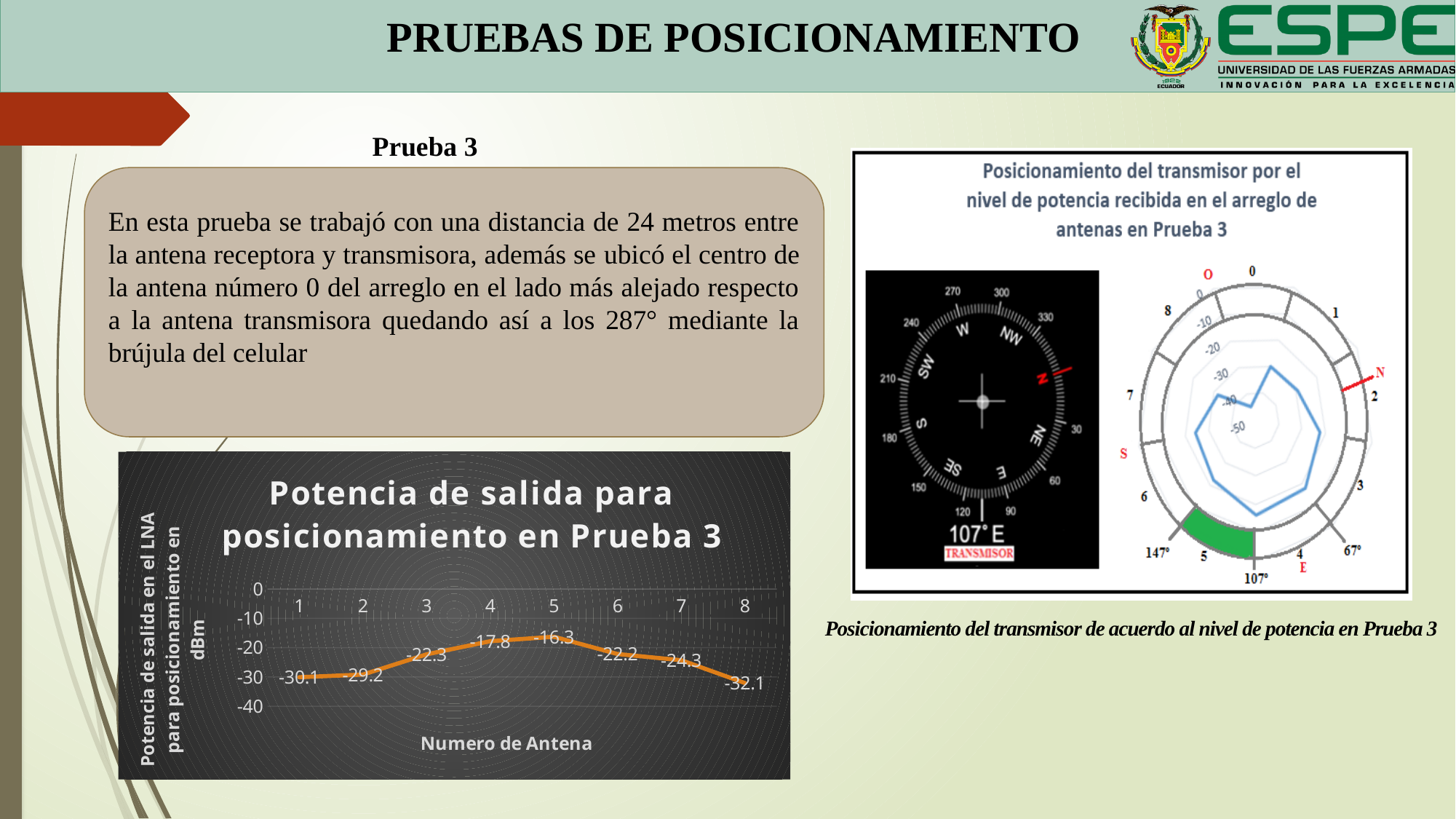
In the chart 'Potencia de salida para posicionamiento en Prueba 3', what is the value for antenna 8? -32.1 In the chart 'Potencia de salida para posicionamiento en Prueba 3', what is the value for antenna 1? -30.1 In the chart 'Potencia de salida para posicionamiento en Prueba 3', what is the value for antenna 5? -16.3 In the chart 'Potencia de salida para posicionamiento en Prueba 3', which antenna number has the highest output power? 5 In the chart 'Potencia de salida para posicionamiento en Prueba 3', which antenna number has the lowest output power? 8 In the chart 'Potencia de salida para posicionamiento en Prueba 3', which has a higher value, antenna 3 or antenna 7? antenna 3 In the chart 'Potencia de salida para posicionamiento en Prueba 3', do the values rise or fall from antenna 5 to antenna 8? fall In the chart 'Potencia de salida para posicionamiento en Prueba 3', what is the value for antenna 4? -17.8 In the chart 'Potencia de salida para posicionamiento en Prueba 3', what is the difference between the values for antenna 5 and antenna 8? 15.8 In the chart 'Potencia de salida para posicionamiento en Prueba 3', how many antenna numbers are plotted on the x axis? 8 What is the x-axis title of the chart 'Potencia de salida para posicionamiento en Prueba 3'? Numero de Antena What kind of chart is 'Potencia de salida para posicionamiento en Prueba 3'? line chart